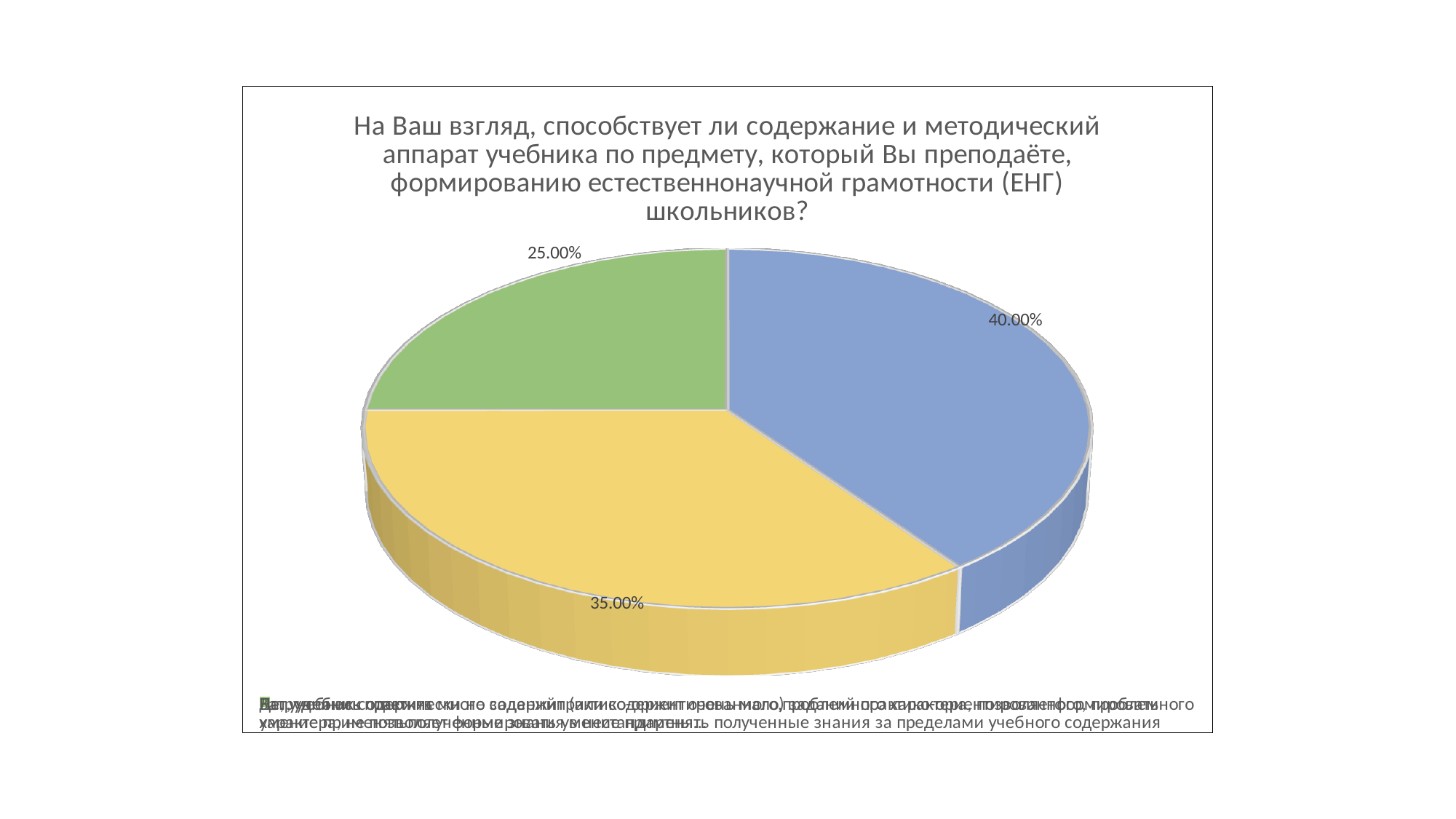
What percentage is shown for the yellow slice of the pie chart? 35.00% What is the difference in percentage points between the blue slice and the green slice? 15.00% What percentage is shown for the green slice of the pie chart? 25.00% What percentage is shown for the blue slice of the pie chart? 40.00% What is the combined share of the yellow and green slices? 60.00% Which colour slice has the largest share of the pie chart? blue Which colour slice has the smallest share of the pie chart? green Which is larger, the yellow slice or the green slice? yellow slice What question does the chart title ask (in Russian)? На Ваш взгляд, способствует ли содержание и методический аппарат учебника по предмету, который Вы преподаёте, формированию естественнонаучной грамотности (ЕНГ) школьников? What kind of chart is shown on the slide? pie chart How many slices does the pie chart have? 3 What is the difference in percentage points between the blue slice and the yellow slice? 5.00%